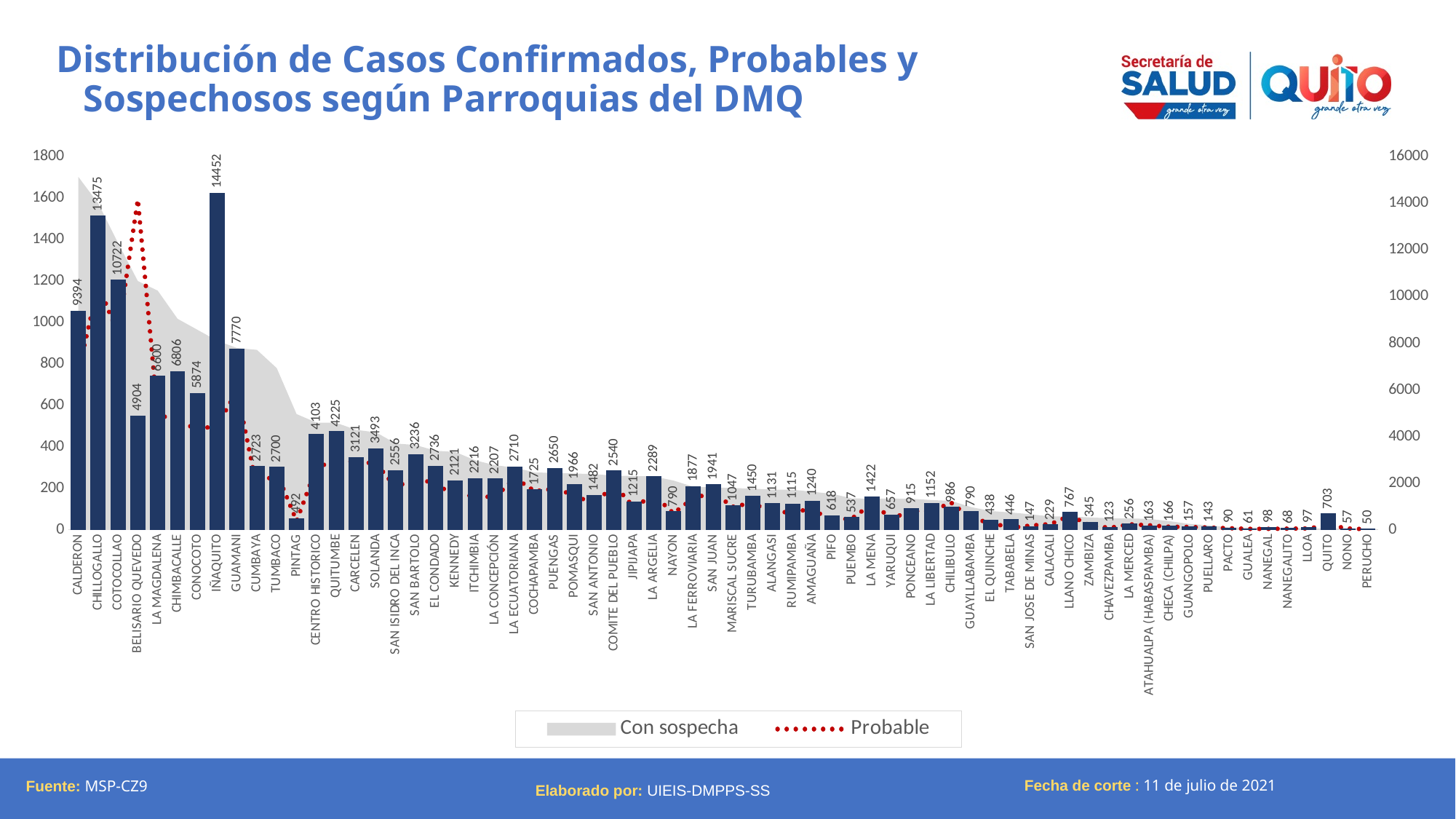
What is the difference between the labelled values for CHILLOGALLO and COTOCOLLAO? 2753 What value is labelled for CHILLOGALLO? 13475 Which parish has the highest labelled value? IÑAQUITO Which series is shown as a red dotted line according to the legend? Probable What value is labelled for QUITO? 703 What value is labelled for IÑAQUITO? 14452 What kind of chart is used for the dark blue series? bar chart Which has the larger labelled value, GUAMANI or CHIMBACALLE? GUAMANI How many series does the legend list? 2 Which parish has the lowest labelled value? PERUCHO What value is labelled for PERUCHO? 50 On the left axis, is the bar for IÑAQUITO greater or less than 1400? greater